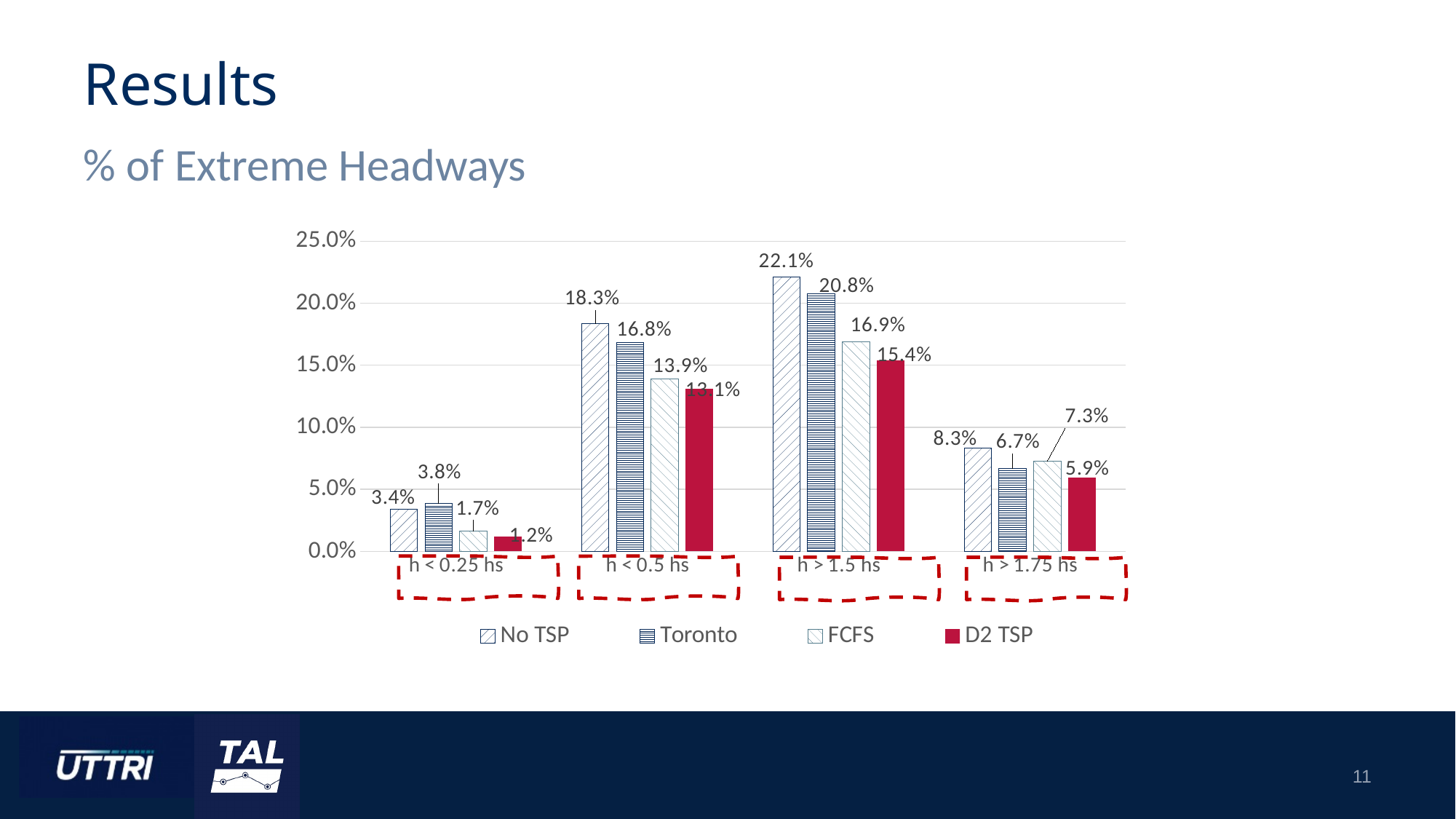
What is the value for D2 TSP in the h < 0.25 hs category? 1.2% How many series does the legend list? 4 Which series has the highest value in the h > 1.5 hs category? No TSP What is the value for Toronto in the h < 0.5 hs category? 16.8% What is the difference between the No TSP and D2 TSP values in the h > 1.5 hs category? 6.7% How many categories are shown on the x axis? 4 Which is larger in the h < 0.25 hs category: No TSP or Toronto? Toronto Which series has the lowest value in the h > 1.75 hs category? D2 TSP What is the value for FCFS in the h > 1.75 hs category? 7.3% What is the value for No TSP in the h > 1.5 hs category? 22.1% What kind of chart is shown on the slide? Bar chart Is the value for FCFS in the h < 0.5 hs category greater or less than 15.0%? less